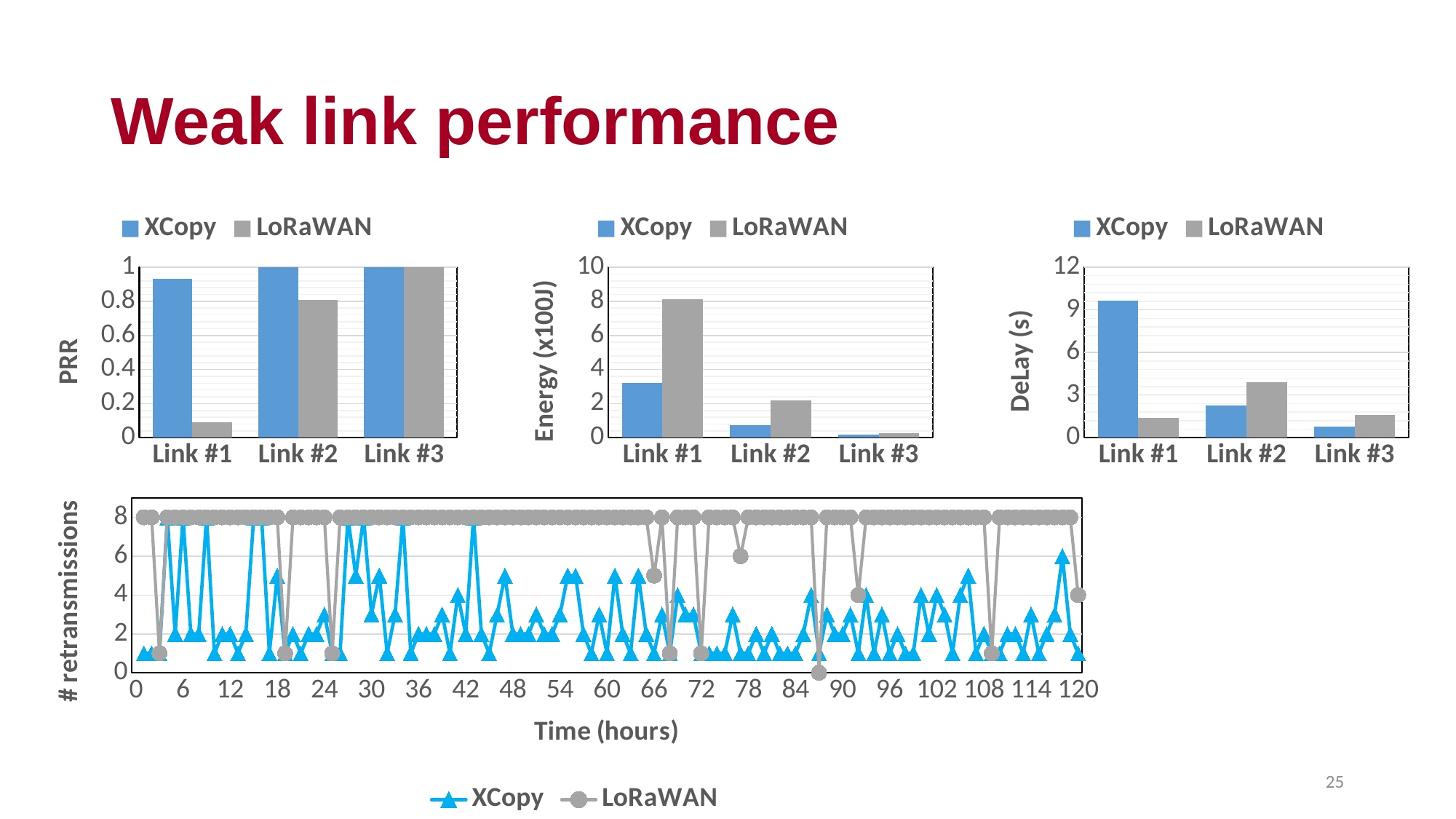
How many series does the legend of the bottom # retransmissions chart list? 2 How many links are shown on the x axis of the PRR chart? 3 In the PRR chart, is the LoRaWAN value for Link #1 greater or less than 0.2? less In the PRR chart, which link has the lowest LoRaWAN value? Link #1 In the Energy (x100J) chart, is the LoRaWAN value for Link #1 greater or less than 6? greater In the Energy (x100J) chart, which series has the larger value for Link #1, XCopy or LoRaWAN? LoRaWAN What kind of chart is the bottom chart showing # retransmissions over Time (hours)? line chart In the DeLay (s) chart, is the XCopy value for Link #1 greater or less than 6? greater In the DeLay (s) chart, which series has the larger value for Link #2, XCopy or LoRaWAN? LoRaWAN In the PRR chart, which series has the larger value for Link #2, XCopy or LoRaWAN? XCopy In the Energy (x100J) chart, which link has the highest LoRaWAN value? Link #1